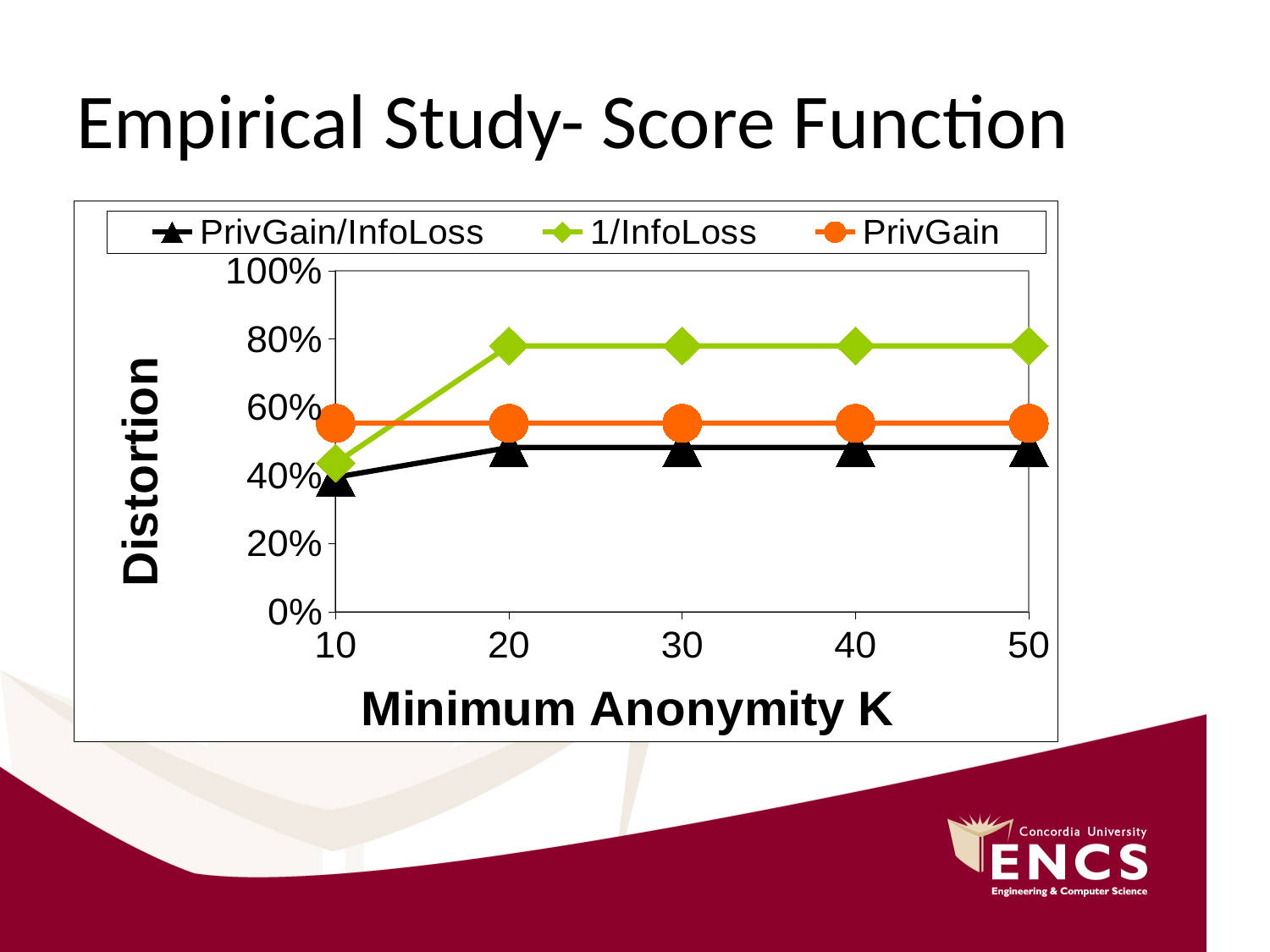
What is the title of the x axis? Minimum Anonymity K At K = 30, which series has the larger Distortion, 1/InfoLoss or PrivGain? 1/InfoLoss Which series has the lowest Distortion at K = 20? PrivGain/InfoLoss How many series does the legend list? 3 What kind of chart is shown on the slide? line chart At K = 10, which series has the larger Distortion, PrivGain or 1/InfoLoss? PrivGain Is the Distortion for 1/InfoLoss at K = 30 greater or less than 60%? greater How does the Distortion for PrivGain change as Minimum Anonymity K increases from 10 to 50? stays flat Is the Distortion for PrivGain/InfoLoss at K = 50 greater or less than 60%? less Which series has the highest Distortion at K = 40? 1/InfoLoss How many values of Minimum Anonymity K are plotted on the x axis? 5 Is the Distortion for 1/InfoLoss at K = 10 greater or less than 60%? less